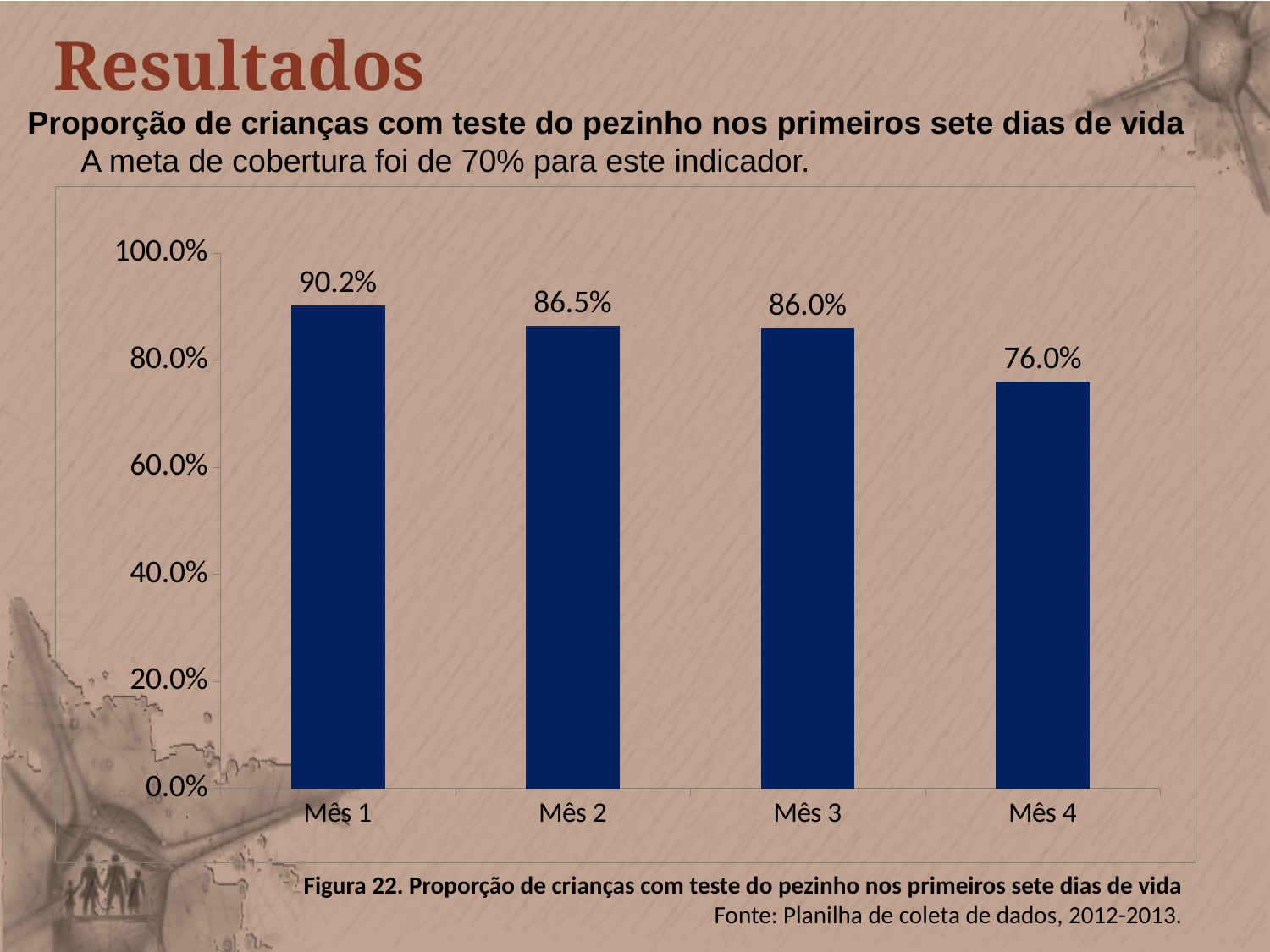
What kind of chart is shown on the slide? bar chart What is the value for Mês 3? 86.0% Is the value for Mês 4 greater or less than 80.0%? less How many months are shown on the chart? 4 Which month has the highest value? Mês 1 Which is larger, the value for Mês 2 or the value for Mês 4? Mês 2 What is the value for Mês 2? 86.5% Do the values rise or fall from Mês 1 to Mês 4? fall What is the value for Mês 4? 76.0% Which month has the lowest value? Mês 4 What is the difference between the values for Mês 1 and Mês 4? 14.2% What is the value for Mês 1? 90.2%